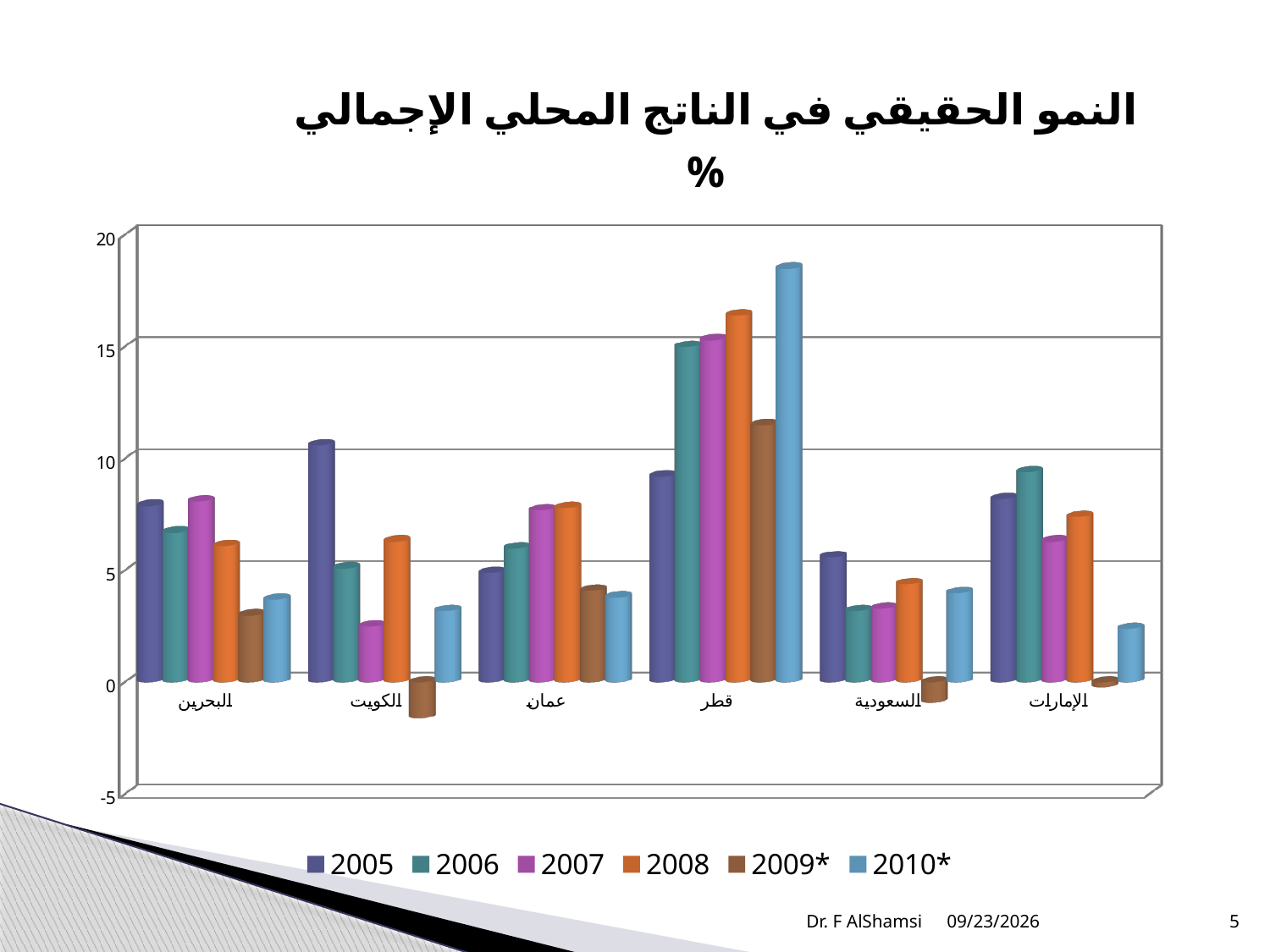
Is the 2009* value for الكويت greater or less than 0? less Is the 2010* value for قطر greater or less than 15? greater Which is larger for الإمارات: the 2006 value or the 2010* value? 2006 How many series does the legend list? 6 How many countries (categories) are shown on the x axis of the chart? 6 Which country has the tallest bar in the chart? قطر Which series is shown in orange in the legend? 2008 What kind of chart is shown on the slide? bar chart Is the 2005 value for الكويت greater or less than 10? greater What is the title of the chart? النمو الحقيقي في الناتج المحلي الإجمالي % Which is larger for البحرين: the 2005 value or the 2009* value? 2005 For قطر, which year has the highest bar? 2010*